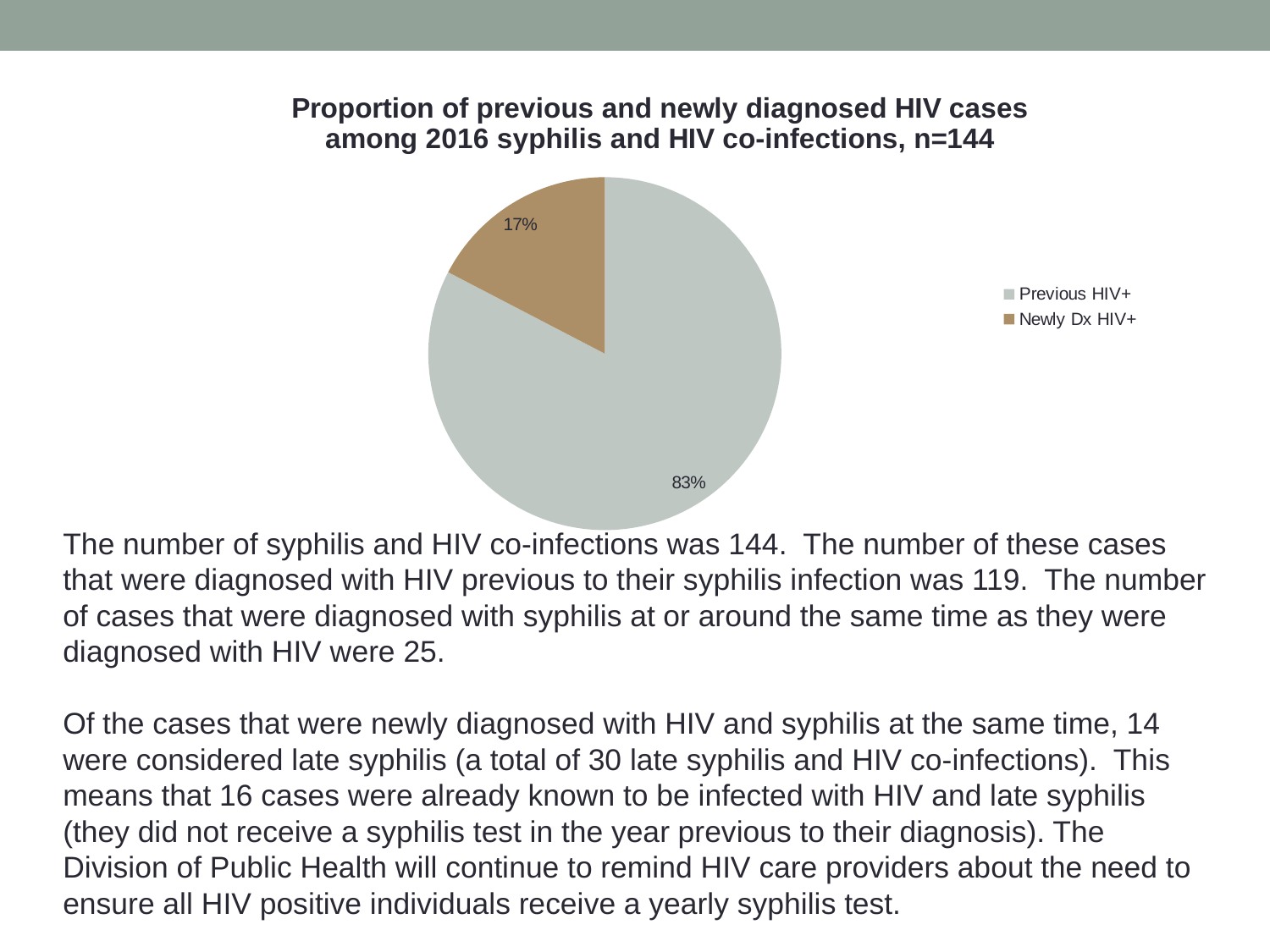
What is the title of the chart? Proportion of previous and newly diagnosed HIV cases among 2016 syphilis and HIV co-infections, n=144 What is the total n stated in the chart title? 144 Which slice of the pie is the largest? Previous HIV+ What is the difference in percentage points between the Previous HIV+ and Newly Dx HIV+ slices? 66 How many entries does the legend list? 2 What share of the pie does Previous HIV+ represent? 83% How many slices does the pie chart have? 2 What type of chart is shown on the slide? pie chart Which is larger, the Previous HIV+ slice or the Newly Dx HIV+ slice? Previous HIV+ What share of the pie does Newly Dx HIV+ represent? 17% Which slice of the pie is the smallest? Newly Dx HIV+